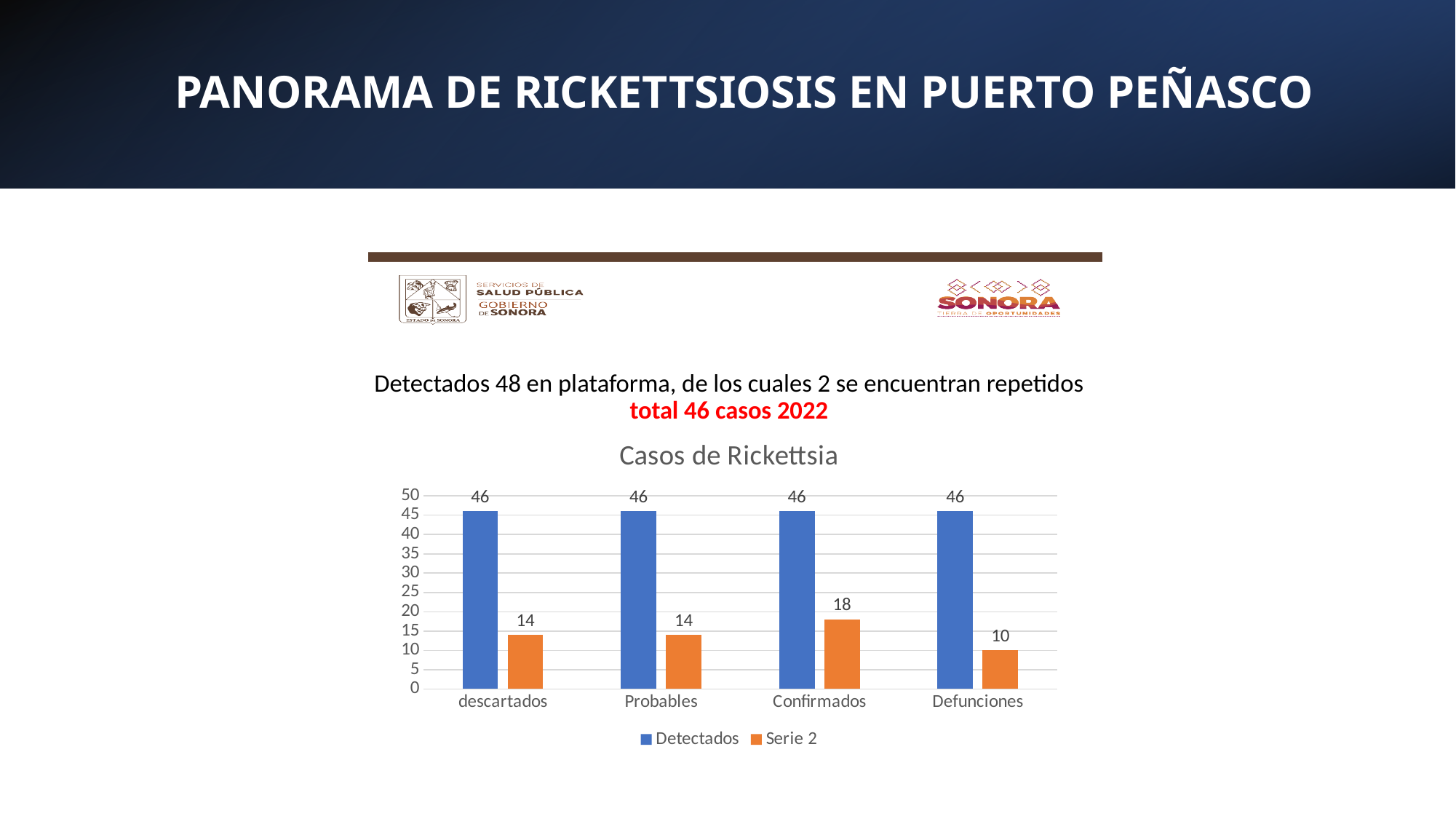
Which series is shown in orange? Serie 2 What is the title of the chart? Casos de Rickettsia How many categories are shown on the x axis? 4 Which category has the highest Serie 2 value? Confirmados What is the Serie 2 value for Confirmados? 18 What is the Serie 2 value for Defunciones? 10 How many series does the legend list? 2 Which category has the lowest Serie 2 value? Defunciones Which is larger, the Serie 2 value for Confirmados or for descartados? Confirmados What kind of chart is shown on the slide? bar chart What is the Detectados value for Probables? 46 What is the difference between the Detectados and Serie 2 values for Confirmados? 28